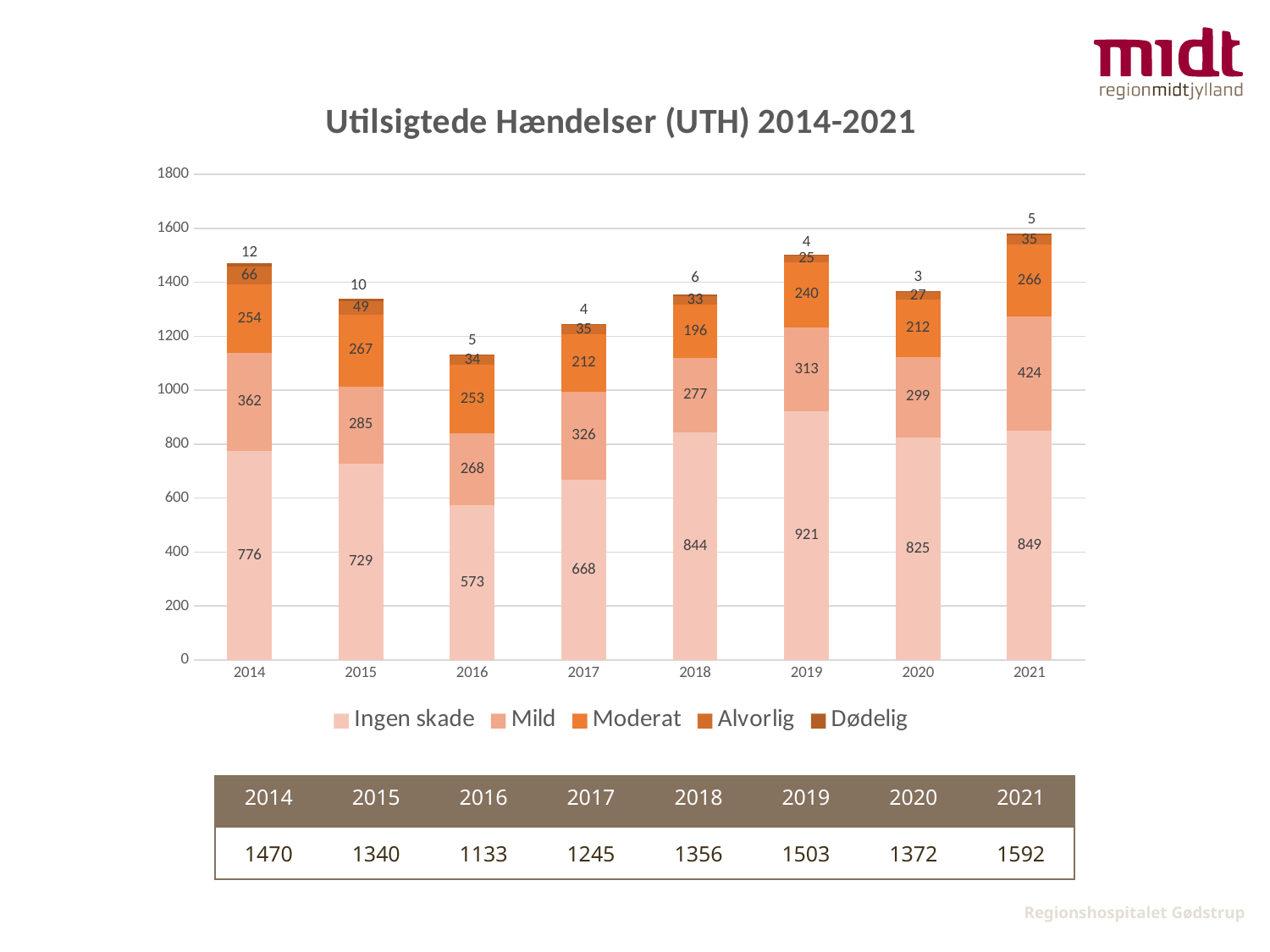
What is the value for Mild in 2021? 424 How many series does the legend list? 5 Which year has the larger Mild value, 2017 or 2019? 2017 What is the value for Ingen skade in 2019? 921 What is the value for Dødelig in 2014? 12 In which year is the Ingen skade value highest? 2019 What is the value for Alvorlig in 2015? 49 What is the difference between the Moderat value in 2014 and in 2018? 58 In which year is the Ingen skade value lowest? 2016 According to the table below the chart, what is the total for 2021? 1592 What kind of chart is shown on the slide? Stacked bar chart How many years are shown on the x axis of the chart? 8